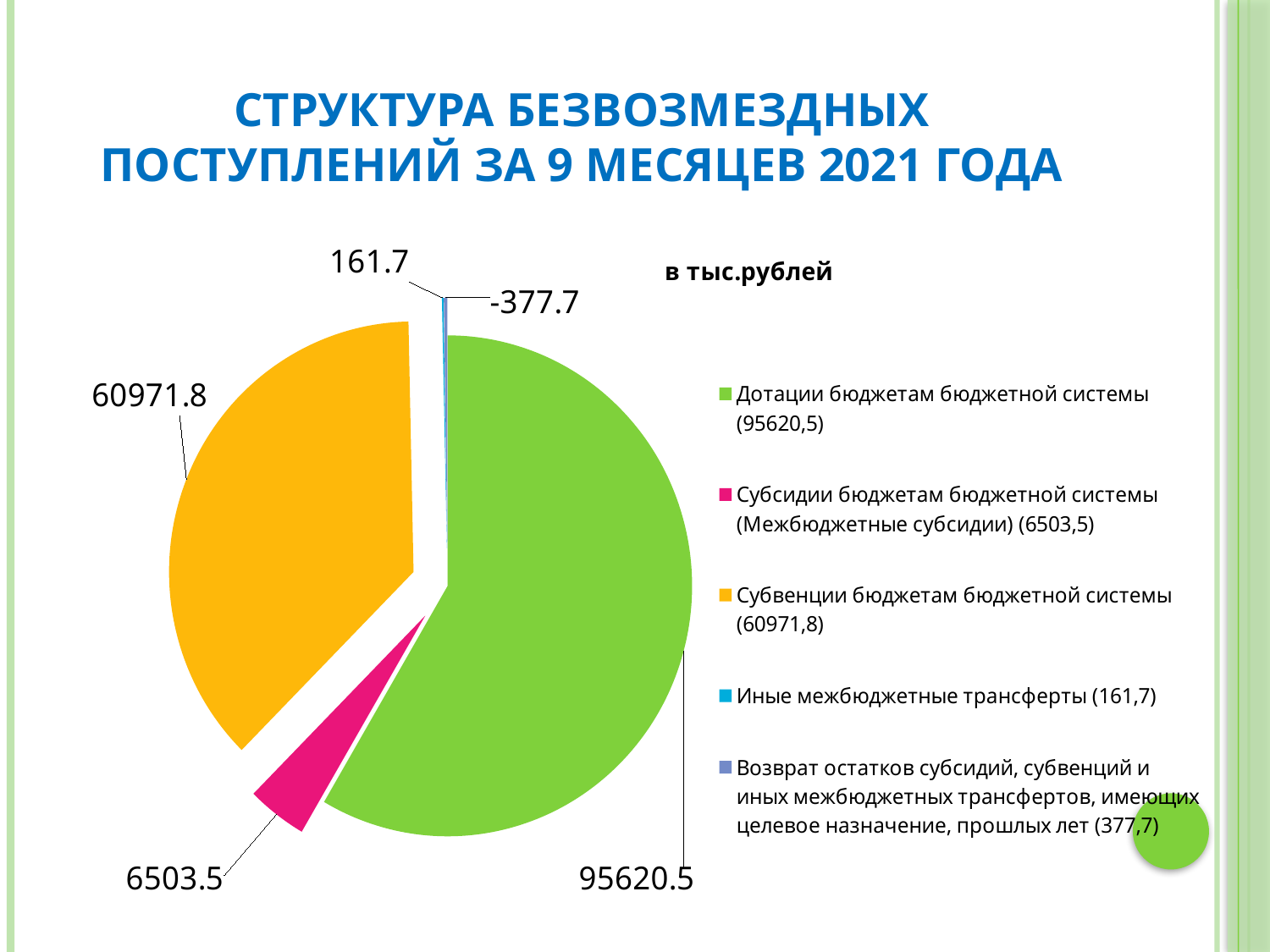
What is the difference between the values for Дотации and Субвенции? 34648.7 What is the value for Субвенции бюджетам бюджетной системы? 60971.8 Which is larger: Субвенции бюджетам бюджетной системы or Субсидии бюджетам бюджетной системы? Субвенции бюджетам бюджетной системы What is the value for Иные межбюджетные трансферты? 161.7 What type of chart is shown on the slide? pie chart What is the value for Субсидии бюджетам бюджетной системы (Межбюджетные субсидии)? 6503.5 In what units are the values on the chart given? тыс.рублей What value is labelled for Возврат остатков субсидий, субвенций и иных межбюджетных трансфертов прошлых лет? -377.7 What is the value for Дотации бюджетам бюджетной системы? 95620.5 Which category has the largest slice of the pie? Дотации бюджетам бюджетной системы How many entries does the legend list? 5 Which category has the lowest value on the chart? Возврат остатков субсидий, субвенций и иных межбюджетных трансфертов, имеющих целевое назначение, прошлых лет